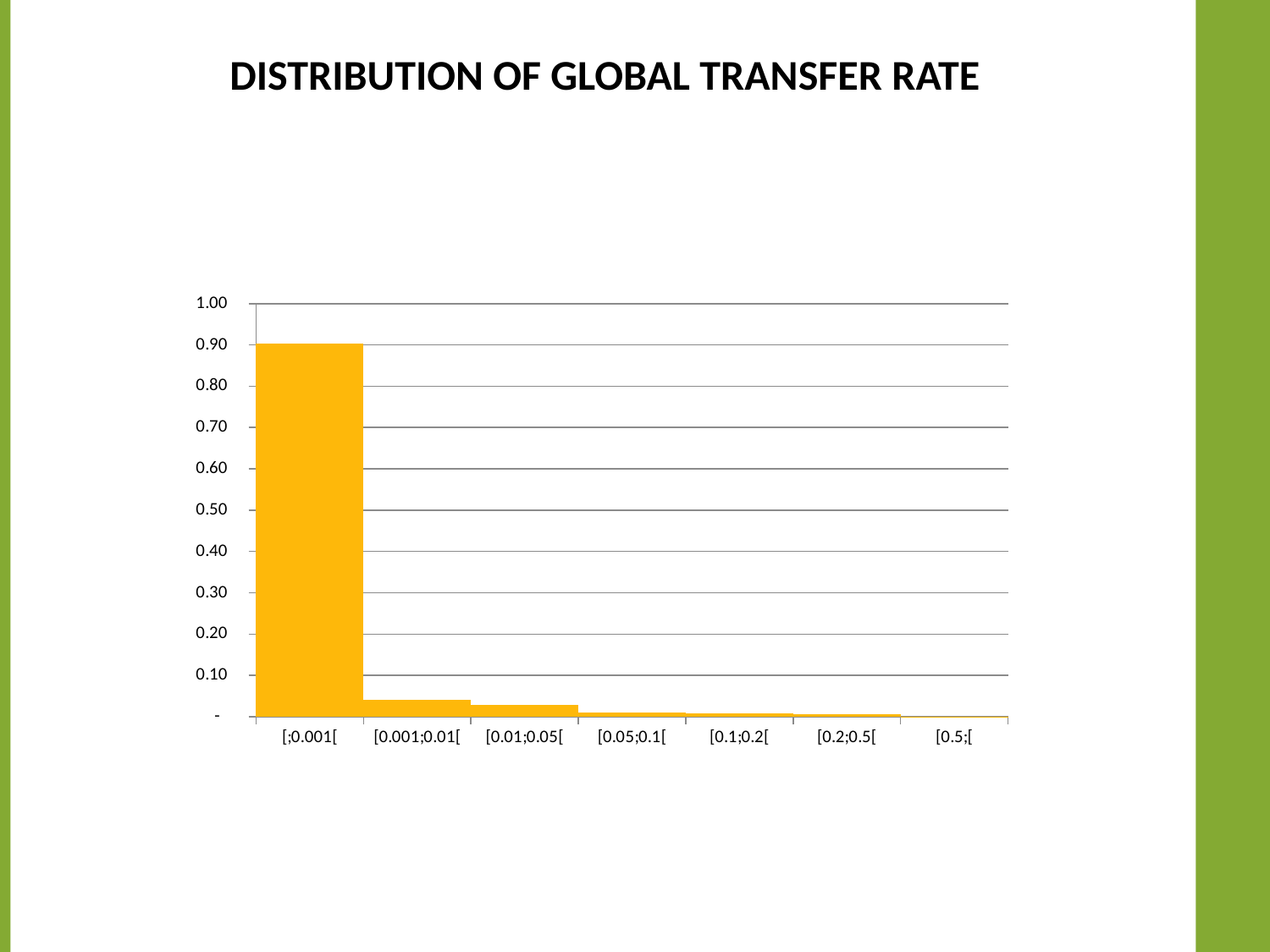
Is the value for [;0.001[ greater or less than 0.50? greater Is the value for [0.01;0.05[ greater or less than 0.10? less Which category has the highest value? [;0.001[ Which is larger, the value for [0.001;0.01[ or the value for [0.05;0.1[? [0.001;0.01[ What is the title of the chart? DISTRIBUTION OF GLOBAL TRANSFER RATE What kind of chart is shown on the slide? Bar chart Is the value for [0.001;0.01[ greater or less than 0.10? less Do the values rise or fall moving from left to right along the x axis? fall How many categories are shown on the x axis? 7 What colour are the bars in the chart? Yellow/orange Which is larger, the value for [;0.001[ or the value for [0.001;0.01[? [;0.001[